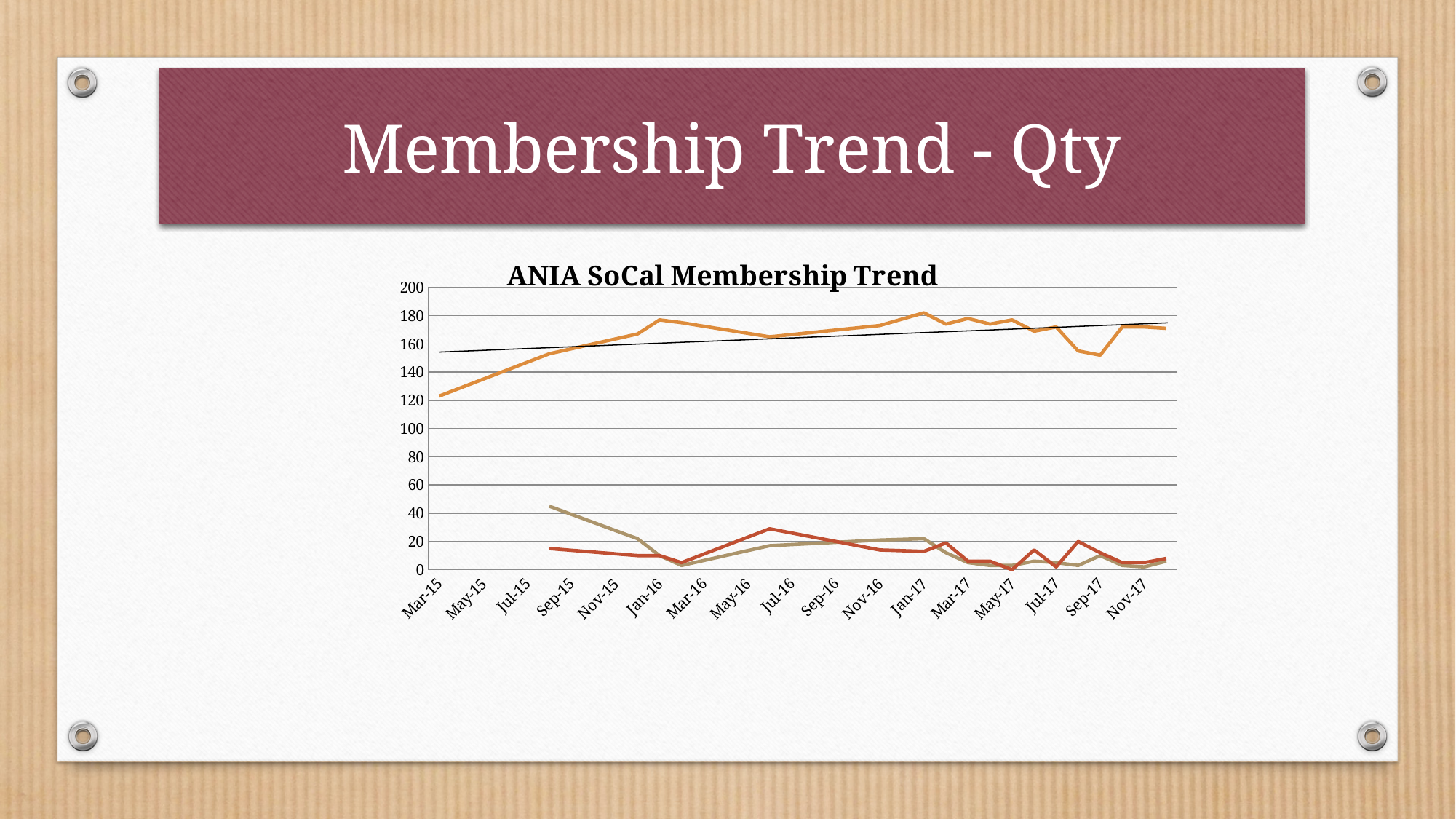
Is the value of the red line at Jul-16 greater or less than 20? greater Is the value of the orange line at Mar-15 greater or less than 140? less Is the value of the orange line at Jul-15 greater or less than 120? greater What is the title of the chart? ANIA SoCal Membership Trend What kind of chart is shown on the slide? line chart Does the orange line generally rise or fall from Mar-15 to Nov-17? rise What is the highest value shown on the vertical axis of the chart? 200 At Jan-16, which is higher, the orange line or the red line? the orange line How many date labels are shown along the x axis of the chart? 17